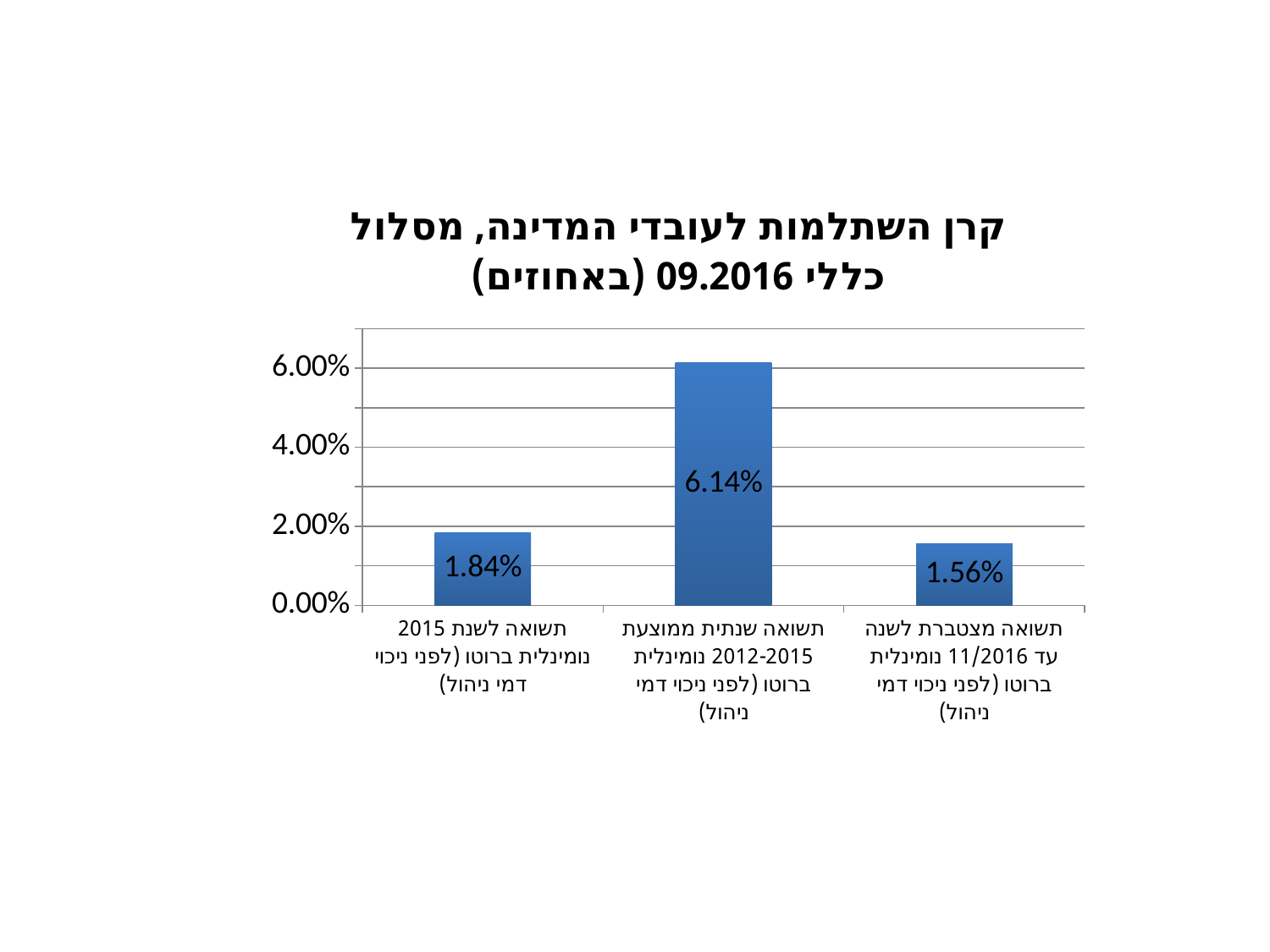
Is the value for "תשואה שנתית ממוצעת 2012-2015" greater or less than 4.00%? greater What is the title of the chart? קרן השתלמות לעובדי המדינה, מסלול כללי 09.2016 (באחוזים) What is the difference between the value for "תשואה שנתית ממוצעת 2012-2015" and the value for "תשואה לשנת 2015"? 4.30% Which is larger: the value for "תשואה לשנת 2015" or the value for "תשואה מצטברת לשנה עד 11/2016"? תשואה לשנת 2015 How many categories are shown in the chart? 3 What kind of chart is shown on the slide? bar chart Which category has the highest value? תשואה שנתית ממוצעת 2012-2015 נומינלית ברוטו (לפני ניכוי דמי ניהול) What is the value for the bar labelled "תשואה מצטברת לשנה עד 11/2016 נומינלית ברוטו (לפני ניכוי דמי ניהול)"? 1.56% What is the value for the bar labelled "תשואה שנתית ממוצעת 2012-2015 נומינלית ברוטו (לפני ניכוי דמי ניהול)"? 6.14% Which category has the lowest value? תשואה מצטברת לשנה עד 11/2016 נומינלית ברוטו (לפני ניכוי דמי ניהול) What is the difference between the value for "תשואה לשנת 2015" and the value for "תשואה מצטברת לשנה עד 11/2016"? 0.28% What is the value for the bar labelled "תשואה לשנת 2015 נומינלית ברוטו (לפני ניכוי דמי ניהול)"? 1.84%